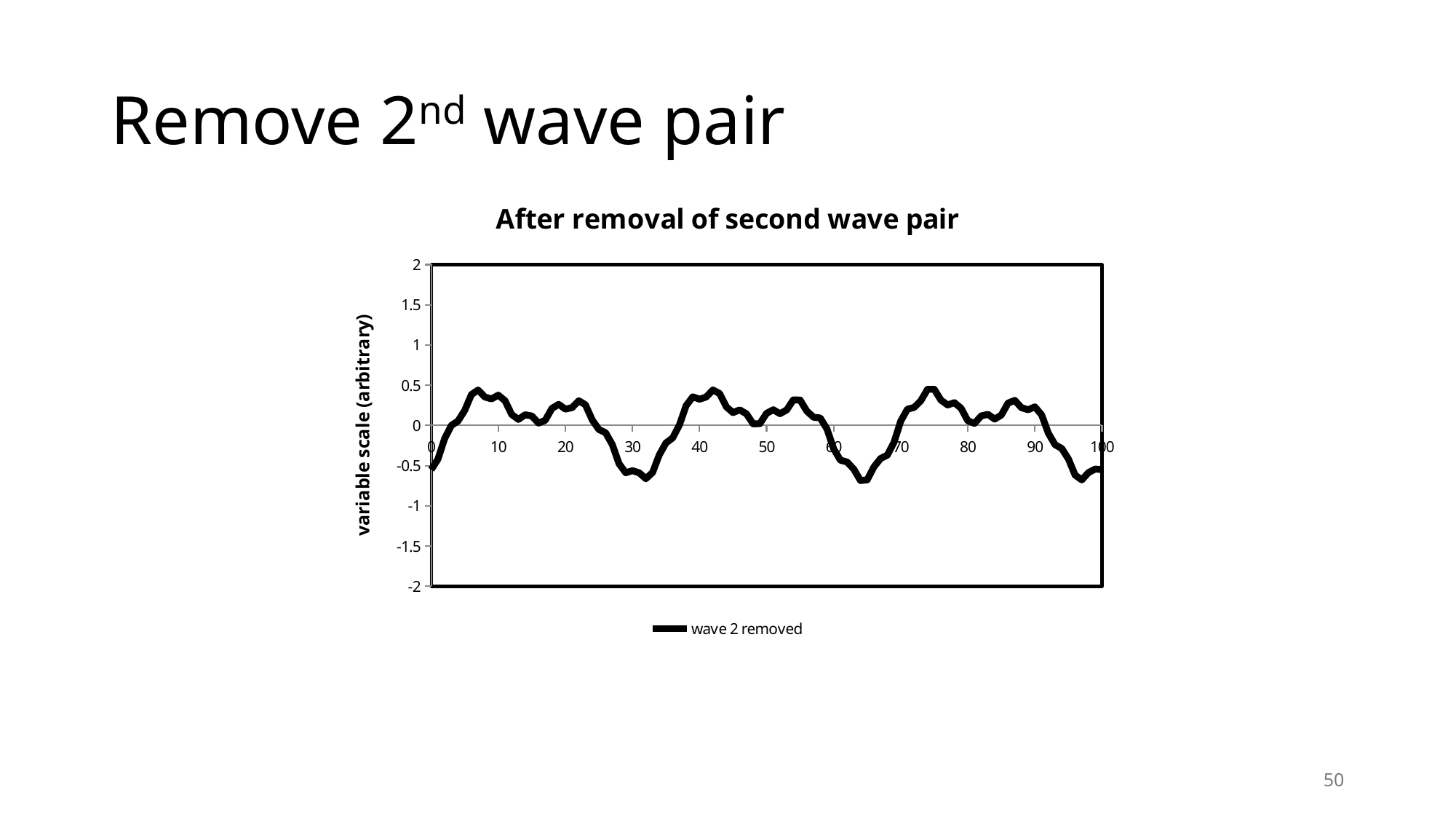
What is the title of the chart? After removal of second wave pair What is the label of the series in the legend? wave 2 removed Is the value for x = 65 greater or less than -0.5? less Is the value for x = 60 greater or less than 0? less What kind of chart is shown on the slide? line chart Is the value for x = 0 greater or less than 0? less How many series does the legend list? 1 Does the line rise or fall between x = 65 and x = 75? rise Does the line rise or fall between x = 55 and x = 65? fall